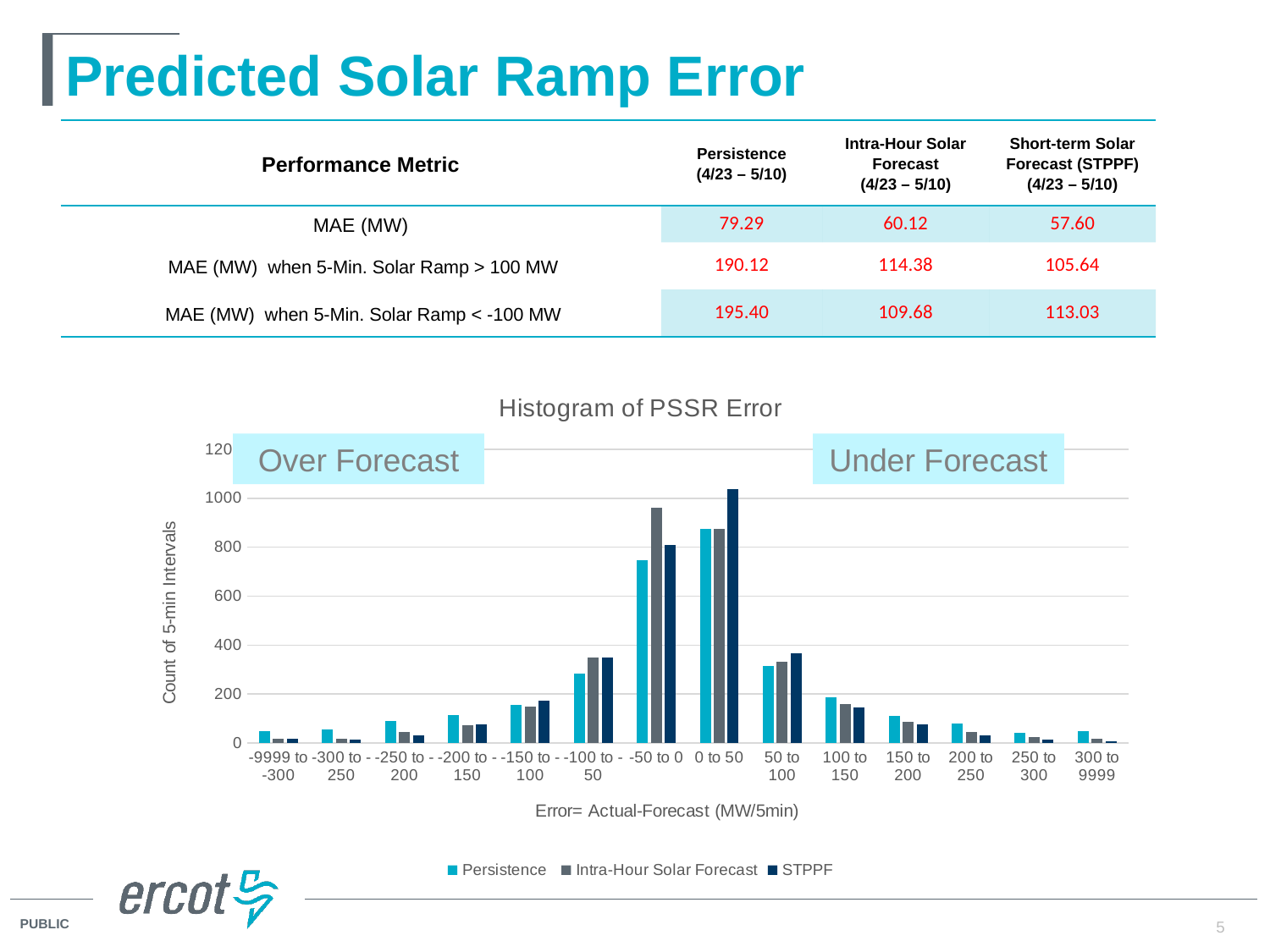
What is the title of the chart? Histogram of PSSR Error How many series does the legend of the histogram list? 3 In which error bin does the STPPF series reach its highest count? 0 to 50 What kind of chart is shown on the slide? bar chart Is the Persistence count for the -100 to -50 bin greater or less than 400? less Is the Persistence count for the -50 to 0 bin greater or less than 800? less In the 0 to 50 bin, which series has the higher count: Persistence or STPPF? STPPF In which error bin does the Intra-Hour Solar Forecast series reach its highest count? -50 to 0 In the -50 to 0 bin, which series has the higher count: Persistence or Intra-Hour Solar Forecast? Intra-Hour Solar Forecast Is the STPPF count for the 0 to 50 bin greater or less than 1000? greater How many error bins are shown along the x axis of the histogram? 14